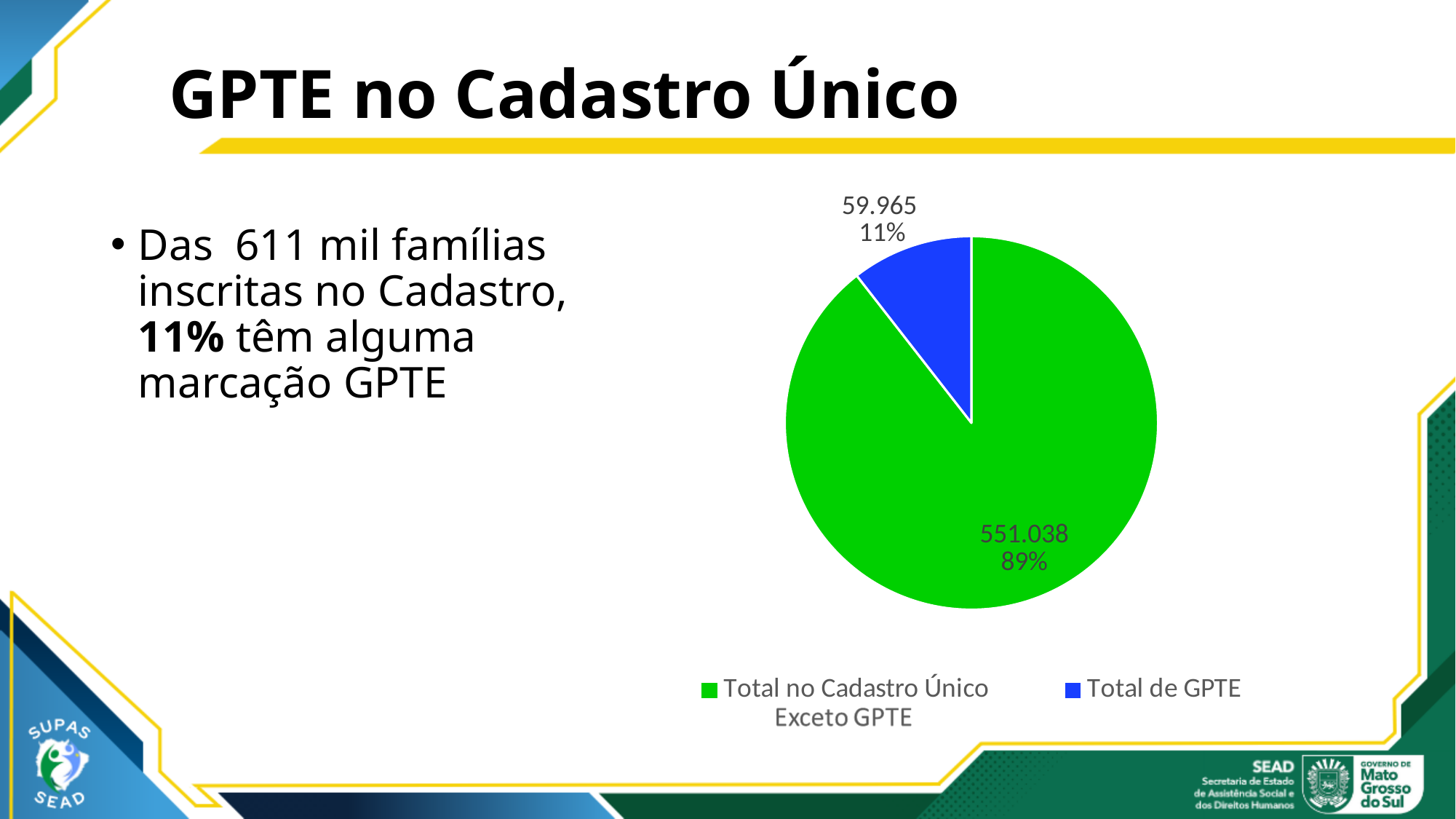
What is the value for Total de GPTE? 59.965 Which slice is the smallest? Total de GPTE Which slice is the largest? Total no Cadastro Único Exceto GPTE How many entries does the legend list? 2 What share of the pie does Total no Cadastro Único Exceto GPTE represent? 89% What colour is the Total de GPTE slice? blue How many slices does the pie chart have? 2 What share of the pie does Total de GPTE represent? 11% What kind of chart is shown on the slide? pie chart Which is larger, Total de GPTE or Total no Cadastro Único Exceto GPTE? Total no Cadastro Único Exceto GPTE What is the difference between Total no Cadastro Único Exceto GPTE and Total de GPTE? 491.073 What is the value for Total no Cadastro Único Exceto GPTE? 551.038